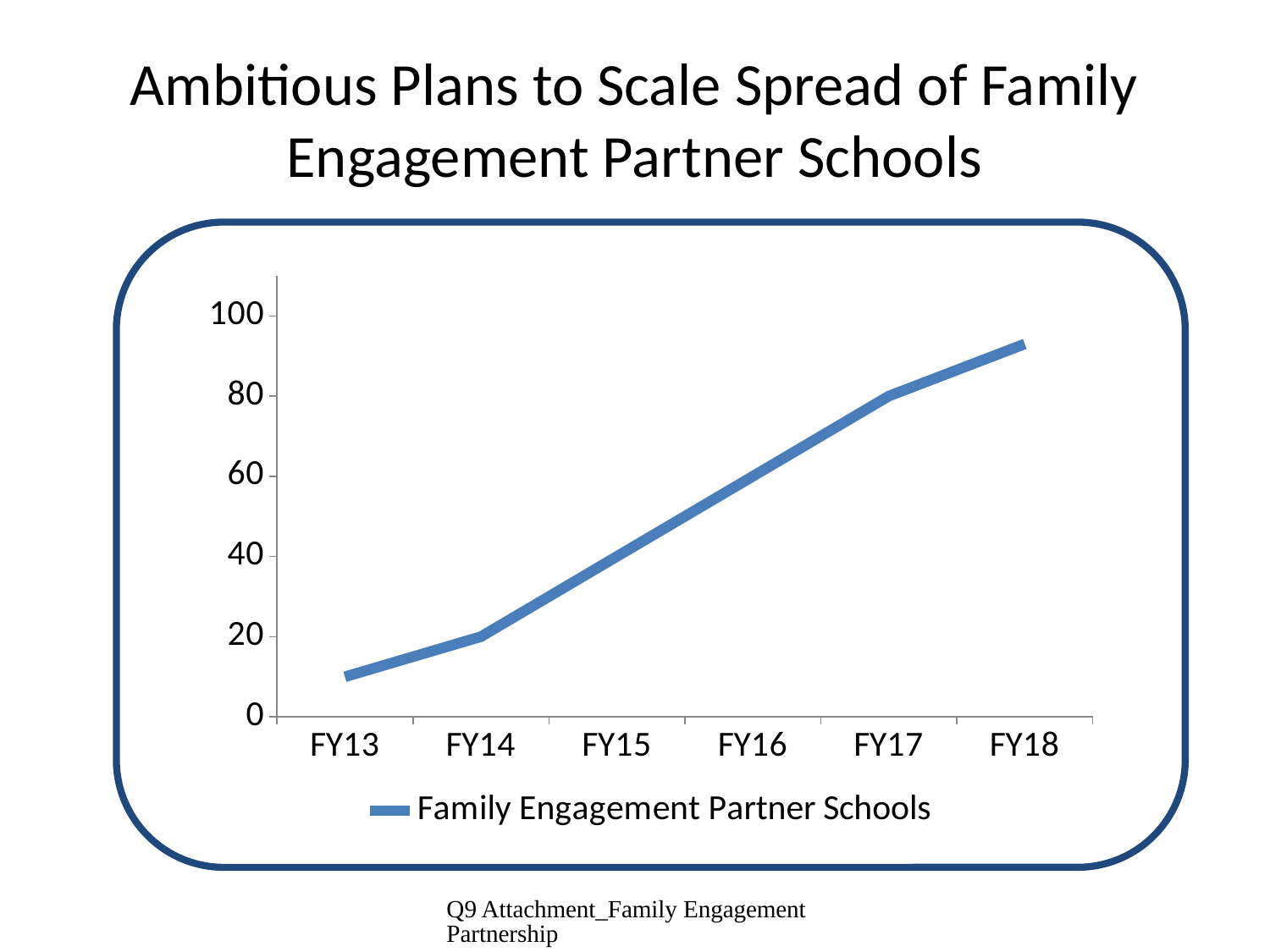
What kind of chart is shown on the slide? line chart How many series does the legend list? 1 How many fiscal years are plotted on the x axis? 6 Which is larger, the value for FY16 or the value for FY14? FY16 Is the value for FY15 greater or less than 60? less What is the name of the series shown in the legend? Family Engagement Partner Schools Is the value for FY13 greater or less than 20? less Do the values rise or fall from FY13 to FY18? rise Which fiscal year has the highest value? FY18 Is the value for FY18 greater or less than 80? greater Which fiscal year has the lowest value? FY13 What is the title of the slide? Ambitious Plans to Scale Spread of Family Engagement Partner Schools